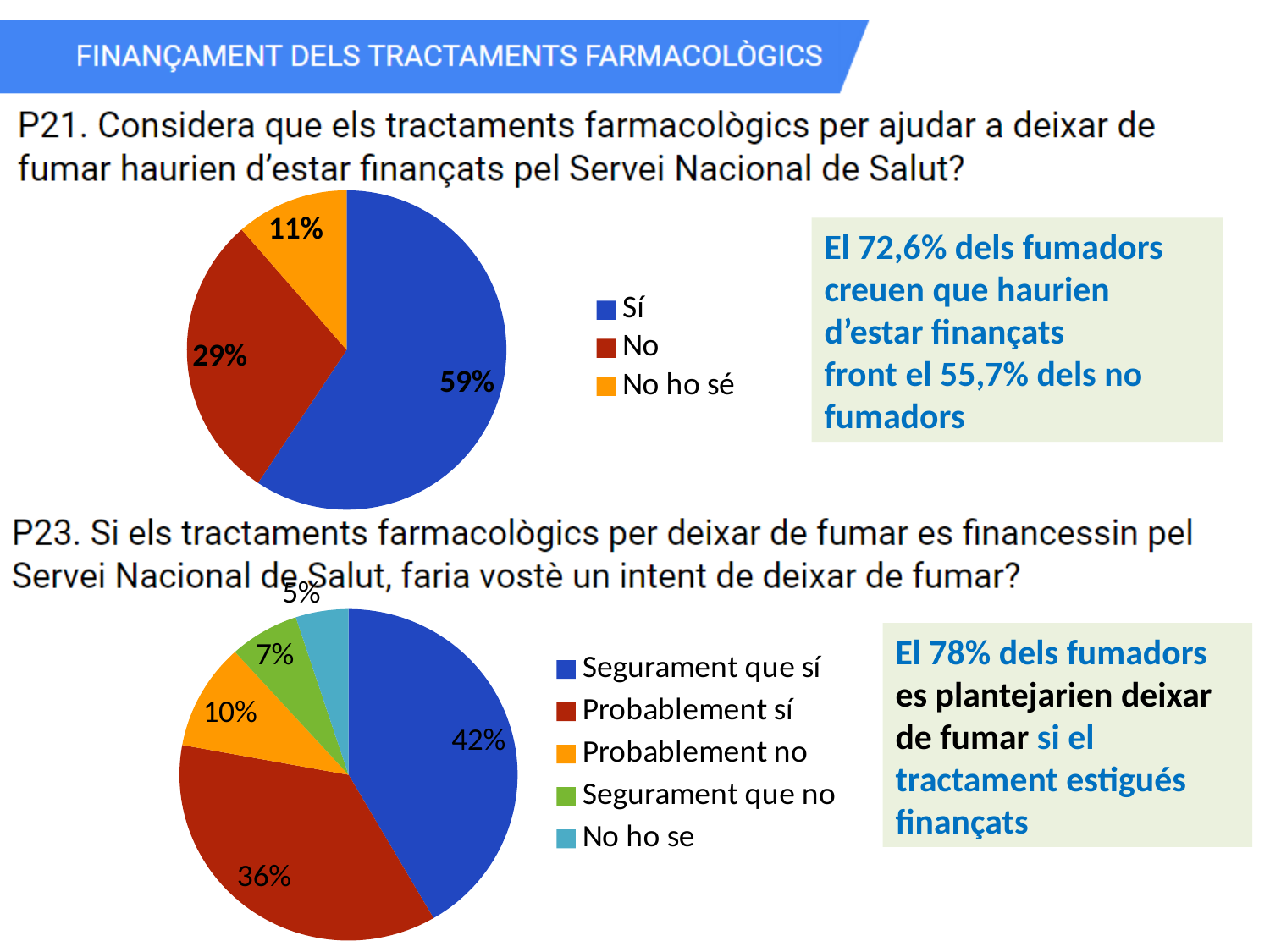
In the P23 pie chart (bottom), which is larger: "Probablement no" or "Segurament que no"? Probablement no In the P23 pie chart (bottom), what is the combined share of "Segurament que sí" and "Probablement sí"? 78% In the P23 pie chart (bottom), what percentage answered "Probablement sí"? 36% In the P21 pie chart (top), what is the difference between the "Sí" and "No" shares? 30% In the P23 pie chart (bottom), what percentage answered "Segurament que no"? 7% In the P23 pie chart (bottom), how many categories does the legend list? 5 In the P21 pie chart (top), what percentage answered "Sí"? 59% In the P23 pie chart (bottom), which response has the smallest share? No ho se In the P21 pie chart (top), what percentage answered "No ho sé"? 11% In the P21 pie chart (top), which response has the largest share? Sí What type of chart is used for P21 (top)? Pie chart In the P21 pie chart (top), how many categories does the legend list? 3